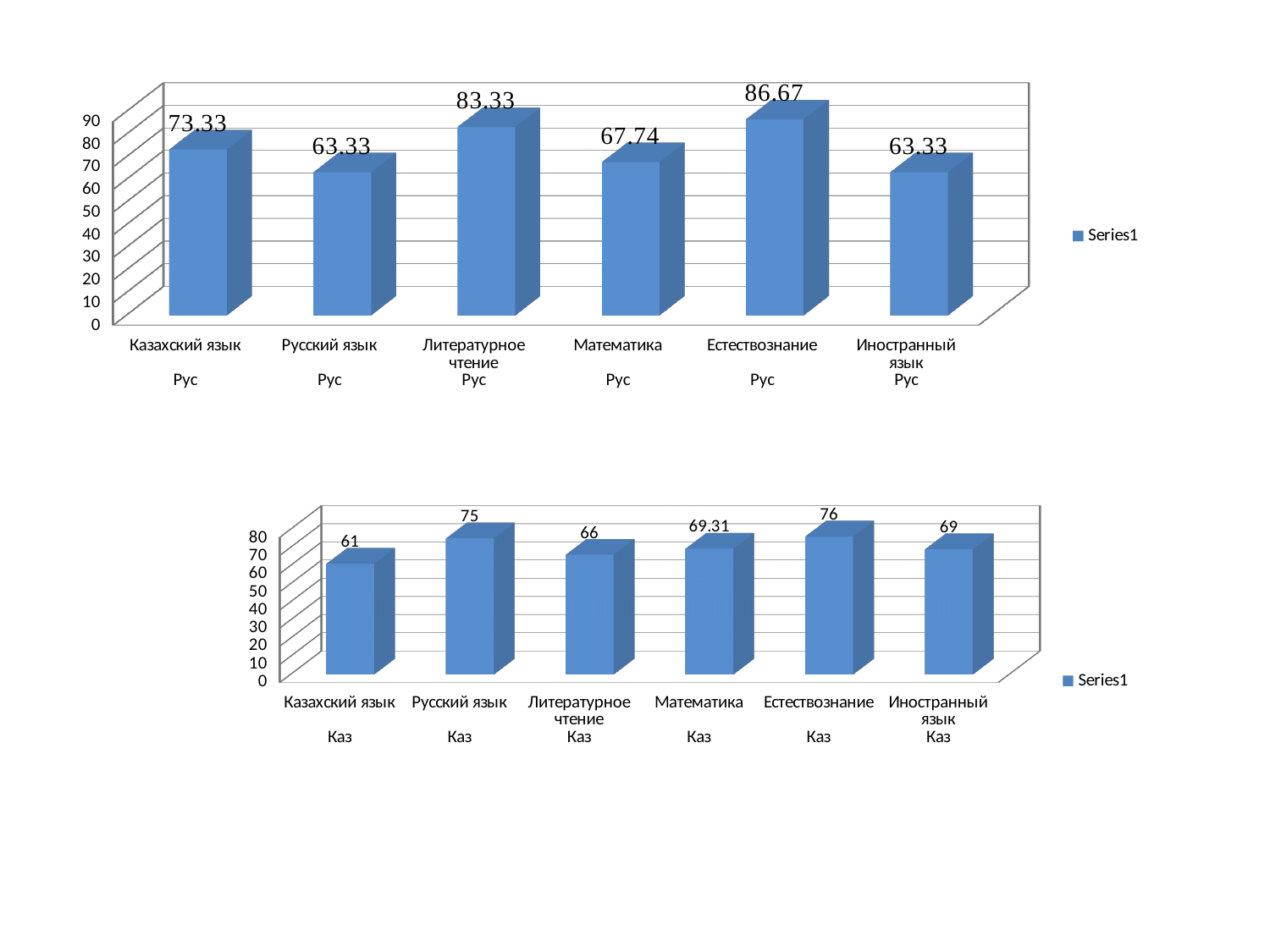
In the top chart, which category has the highest value? Естествознание Рус In the top chart, what is the value for Естествознание Рус? 86.67 In the bottom chart, which category has the lowest value? Казахский язык Каз In the top chart, what is the difference between Литературное чтение Рус and Казахский язык Рус? 10 In the top chart, how many categories are shown? 6 In the bottom chart, which is larger: Русский язык Каз or Литературное чтение Каз? Русский язык Каз In the bottom chart, what is the difference between Естествознание Каз and Иностранный язык Каз? 7 What type of chart is the bottom chart? Bar chart In the bottom chart, what is the value for Математика Каз? 69.31 In the top chart, what is the value for Математика Рус? 67.74 In the bottom chart, what is the value for Казахский язык Каз? 61 How many series does the legend of the top chart list? 1